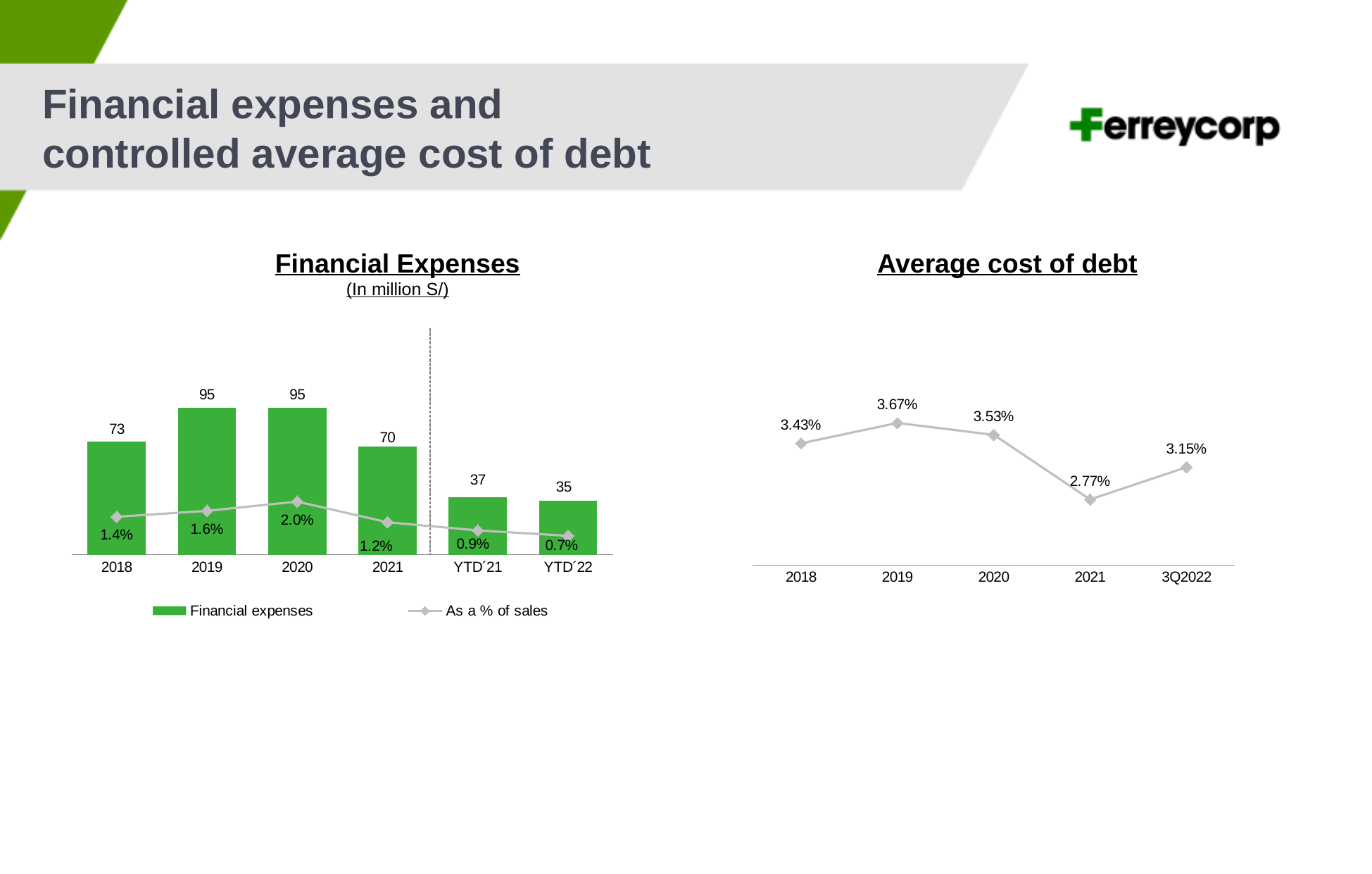
In the Financial Expenses chart, what is the financial expenses value for YTD´22? 35 In the Financial Expenses chart, which category has the lowest financial expenses? YTD´22 In the Average cost of debt chart, what is the difference between the 2019 and 2021 values? 0.90% In the Average cost of debt chart, which year has the highest average cost of debt? 2019 In the Financial Expenses chart, how many series does the legend list? 2 In the Financial Expenses chart, what is the difference in financial expenses between 2020 and 2021? 25 In the Average cost of debt chart, is the value for 2020 larger or smaller than the value for 3Q2022? larger In the Average cost of debt chart, what is the value for 2021? 2.77% In the Financial Expenses chart, what is the value of financial expenses for 2018? 73 What kind of chart is the Average cost of debt chart? line chart In the Financial Expenses chart, what is the 'As a % of sales' value for 2020? 2.0% In the Financial Expenses chart, how many categories are shown on the x axis? 6